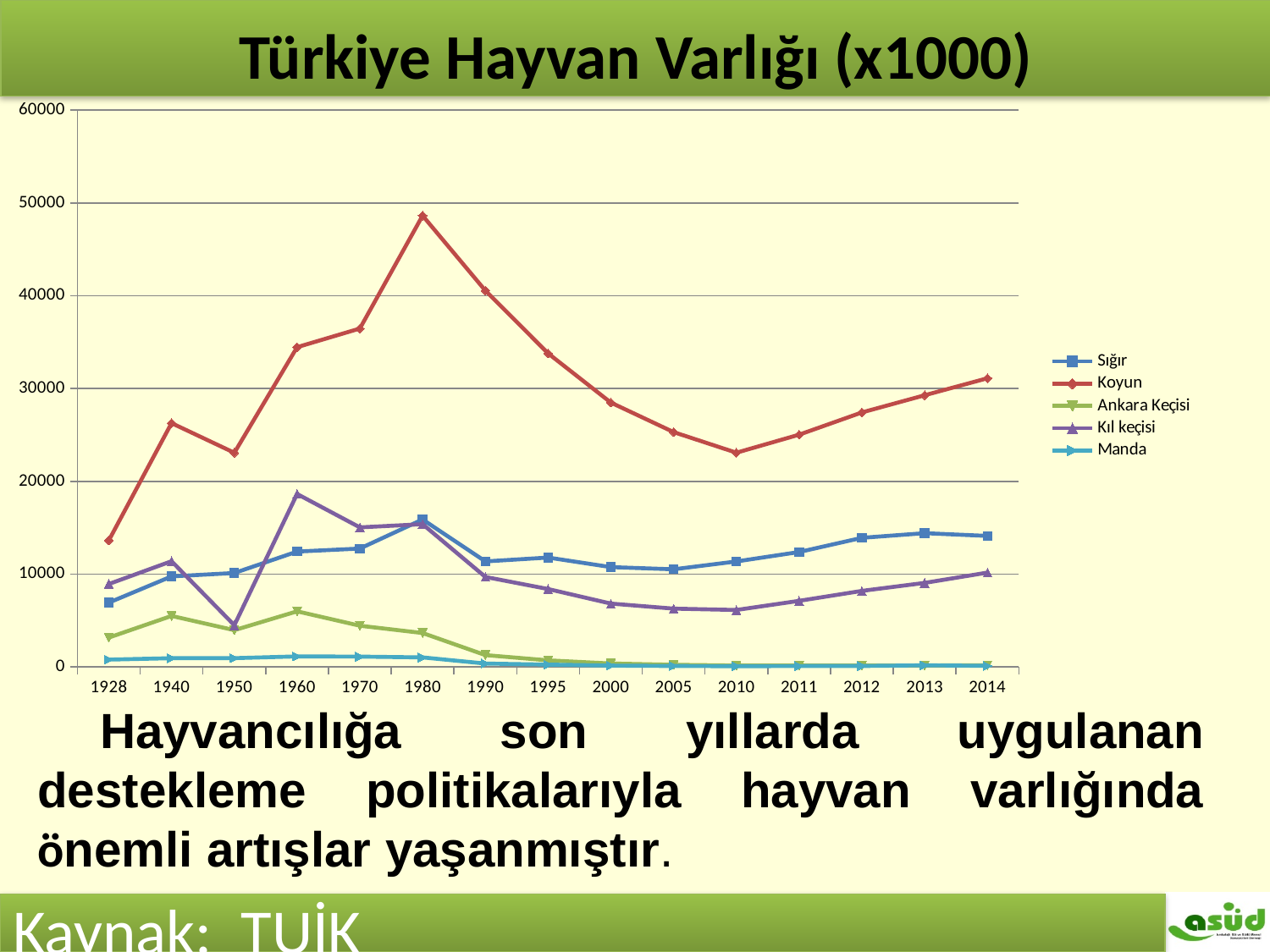
How many series does the legend list? 5 Which series has the highest values across the whole chart? Koyun What is the title of the chart? Türkiye Hayvan Varlığı (x1000) Is the value for Sığır in 2014 greater or less than 10000? greater Which is larger in 1960, Kıl keçisi or Sığır? Kıl keçisi What kind of chart is shown on the slide? line chart How many years are shown along the x axis? 15 Does the Koyun series rise or fall from 2010 to 2014? rise In which year does the Koyun series reach its peak? 1980 Is the value for Koyun in 2010 greater or less than 30000? less Is the value for Koyun in 1980 greater or less than 40000? greater